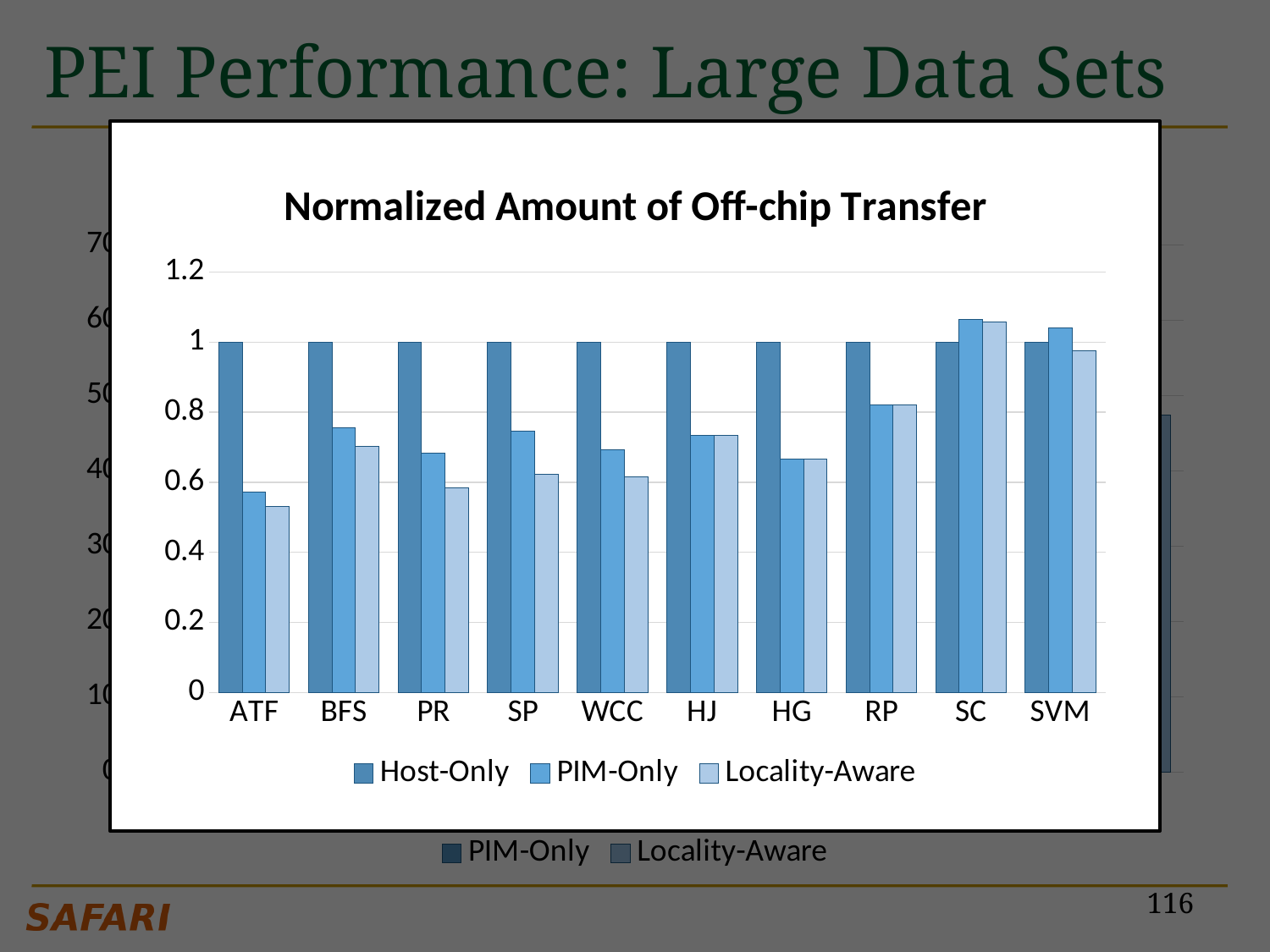
In the "Normalized Amount of Off-chip Transfer" chart, how many categories are shown on the x axis? 10 In the "Normalized Amount of Off-chip Transfer" chart, which category has the lowest Locality-Aware value? ATF In the "Normalized Amount of Off-chip Transfer" chart, which is larger: the PIM-Only value for SC or the PIM-Only value for ATF? SC In the "Normalized Amount of Off-chip Transfer" chart, what kind of chart is shown? bar chart In the "Normalized Amount of Off-chip Transfer" chart, is the Locality-Aware value for ATF greater or less than 0.6? less In the "Normalized Amount of Off-chip Transfer" chart, is the PIM-Only value for SC greater or less than 1? greater In the "Normalized Amount of Off-chip Transfer" chart, how many series does the legend list? 3 In the "Normalized Amount of Off-chip Transfer" chart, what is the Host-Only value for ATF? 1 In the "Normalized Amount of Off-chip Transfer" chart, is the PIM-Only value for BFS greater or less than 0.8? less In the "Normalized Amount of Off-chip Transfer" chart, which category has the highest Locality-Aware value? SC In the "Normalized Amount of Off-chip Transfer" chart, what are the three series named in the legend? Host-Only, PIM-Only, Locality-Aware